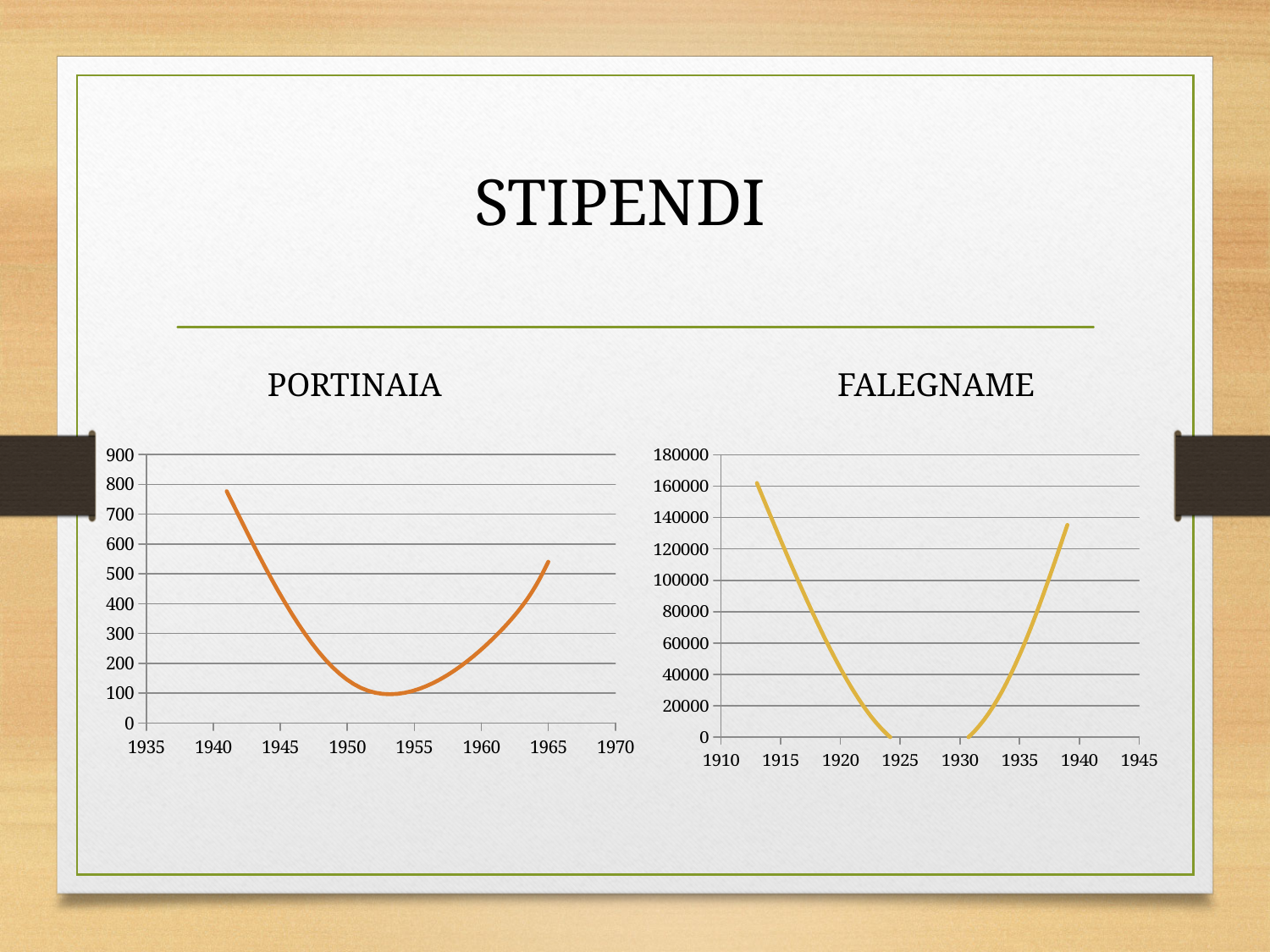
What are the titles of the two charts on the slide? PORTINAIA and FALEGNAME In the FALEGNAME chart, is the value at the end of the curve (around 1939) greater or less than 100000? greater In the PORTINAIA chart, is the value at the end of the curve (around 1965) greater or less than 400? greater In the PORTINAIA chart, is the value around 1950 greater or less than 300? less In the PORTINAIA chart, do the values rise or fall along the x axis from 1955 to 1965? rise What kind of chart is the FALEGNAME chart? line chart In the FALEGNAME chart, do the values rise or fall along the x axis from 1931 to 1939? rise What kind of chart is the PORTINAIA chart? line chart In the PORTINAIA chart, do the values rise or fall along the x axis from 1941 to 1953? fall